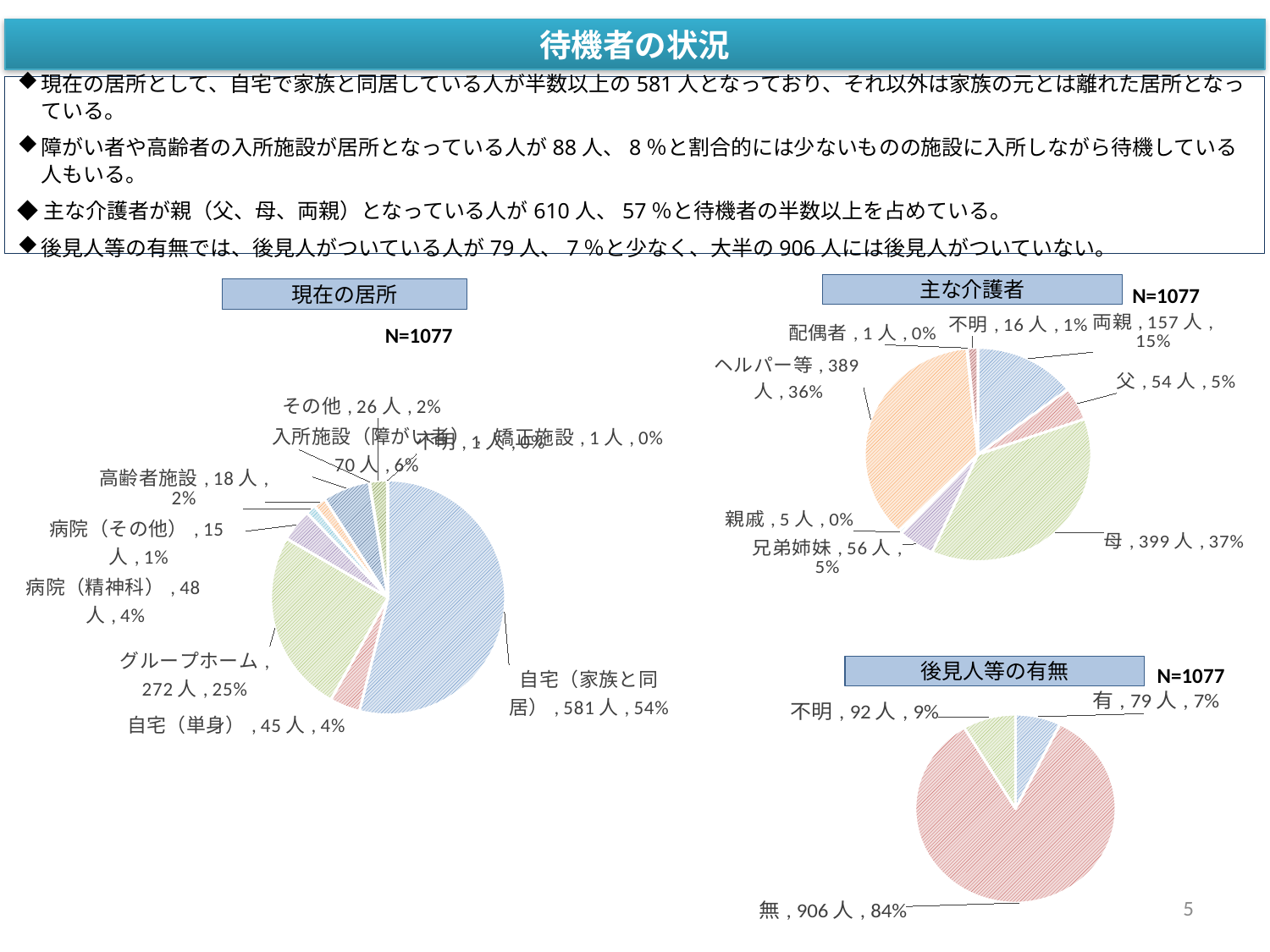
In the 主な介護者 chart, which category has the smallest number of people? 配偶者 In the 主な介護者 chart, what percentage share does ヘルパー等 have? 36% In the 現在の居所 chart, what percentage share does グループホーム have? 25% In the 現在の居所 chart, which category has the largest number of people? 自宅（家族と同居） In the 主な介護者 chart, how many people have 母 as their main caregiver? 399 人 What type of chart is the 後見人等の有無 chart? Pie chart In the 現在の居所 chart, what is the difference in people between 自宅（家族と同居） and グループホーム? 309 人 In the 主な介護者 chart, what is the difference in people between 母 and ヘルパー等? 10 人 In the 後見人等の有無 chart, how many people are in the 無 category? 906 人 In the 後見人等の有無 chart, how many categories are shown? 3 In the 現在の居所 chart, how many people are in the 自宅（家族と同居） category? 581 人 In the 現在の居所 chart, which has more people: 病院（精神科） or 高齢者施設? 病院（精神科）